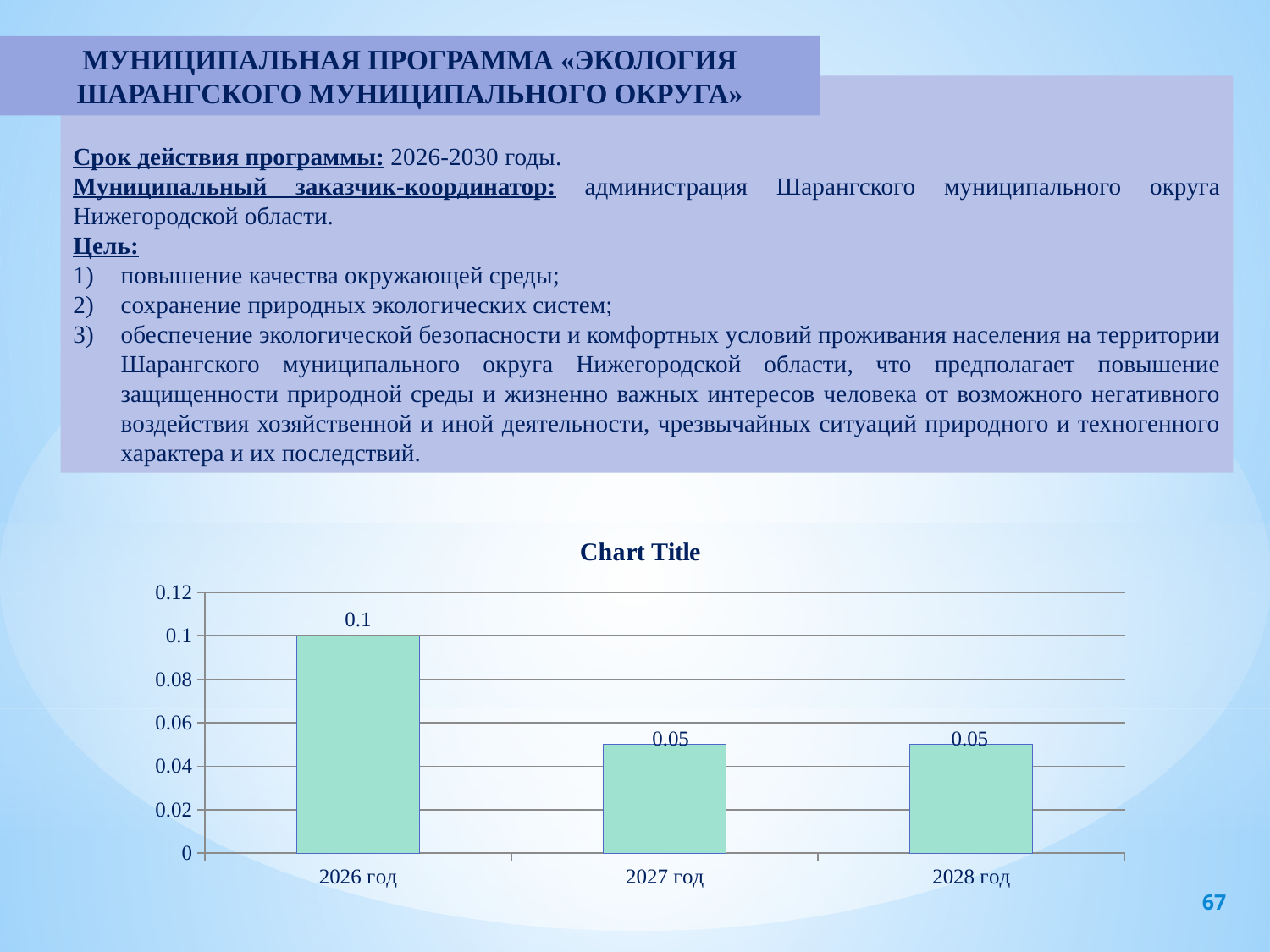
What is the highest value shown on the vertical axis? 0.12 What is the value for 2028 год? 0.05 Do the values rise or fall from 2026 год to 2027 год? fall What is the value for 2027 год? 0.05 Is the value for 2027 год greater or less than 0.08? less What is the difference between the values for 2026 год and 2027 год? 0.05 What is the title of the chart? Chart Title How many categories are shown on the x axis? 3 What kind of chart is shown on the slide? bar chart What is the value for 2026 год? 0.1 Which is larger, the value for 2026 год or the value for 2028 год? 2026 год Which category has the highest value? 2026 год